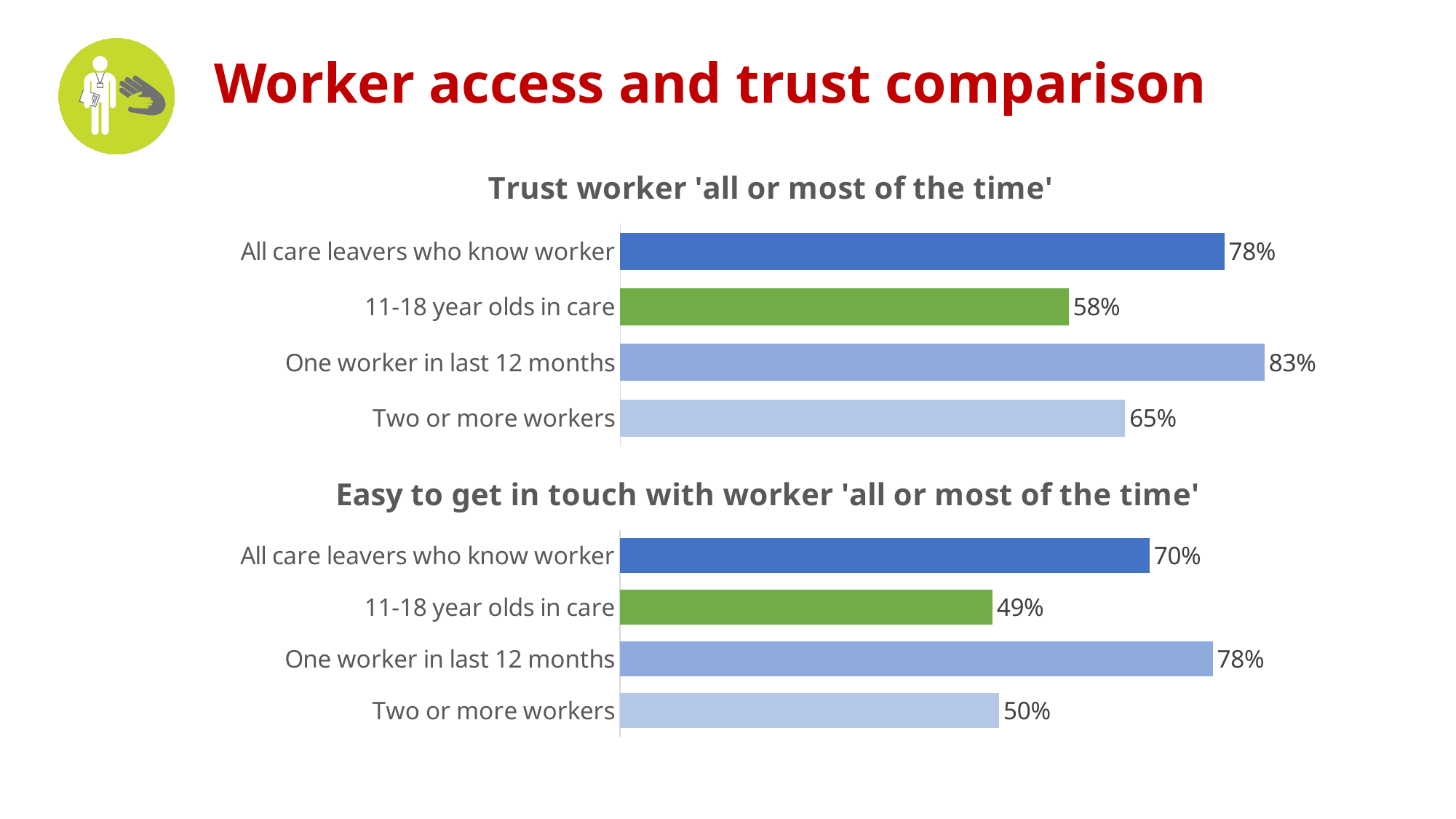
What is the title of the top chart on the slide? Trust worker 'all or most of the time' How many charts are shown on the slide? 2 What type of chart is the 'Easy to get in touch with worker all or most of the time' chart? Bar chart In the 'Trust worker all or most of the time' chart, what is the value for 11-18 year olds in care? 58% In the 'Easy to get in touch with worker all or most of the time' chart, which category has the lowest value? 11-18 year olds in care In the 'Easy to get in touch with worker all or most of the time' chart, which is larger: All care leavers who know worker or One worker in last 12 months? One worker in last 12 months In the 'Trust worker all or most of the time' chart, what is the difference between One worker in last 12 months and Two or more workers? 18% In the 'Trust worker all or most of the time' chart, what is the value for All care leavers who know worker? 78% How many categories are shown in the 'Trust worker all or most of the time' chart? 4 In the 'Easy to get in touch with worker all or most of the time' chart, what is the difference between All care leavers who know worker and 11-18 year olds in care? 21% In the 'Easy to get in touch with worker all or most of the time' chart, what is the value for Two or more workers? 50% In the 'Trust worker all or most of the time' chart, which category has the highest value? One worker in last 12 months